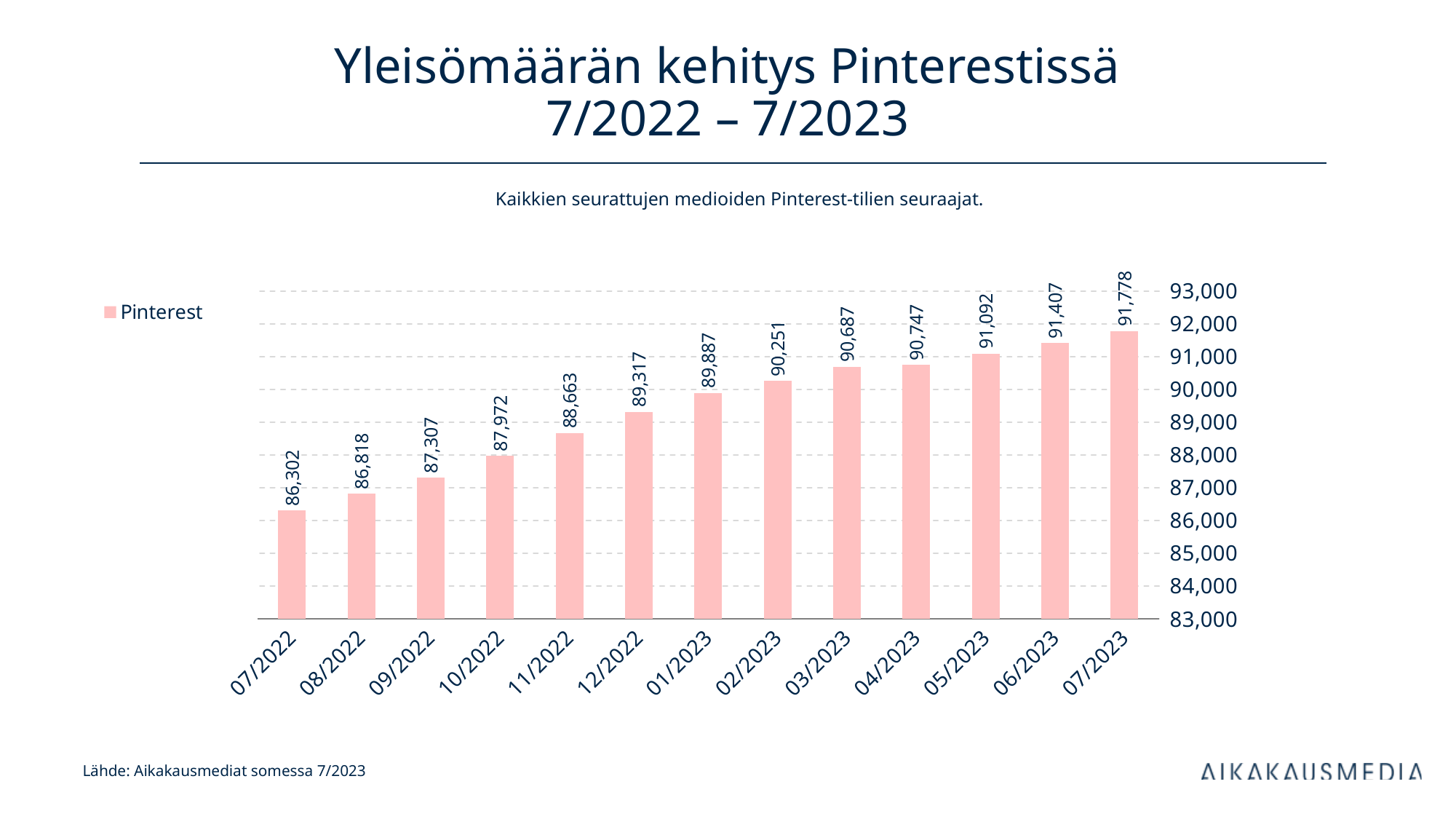
Do the values rise or fall from 07/2022 to 07/2023? rise How many series does the legend list? 1 What is the value for 07/2022? 86,302 Is the value for 10/2022 greater or less than 89,000? less What is the value for 01/2023? 89,887 How many months are shown on the x axis? 13 Which month has the highest value? 07/2023 What is the value for 07/2023? 91,778 Which is larger, the value for 11/2022 or the value for 12/2022? 12/2022 Which month has the lowest value? 07/2022 What is the difference between the values for 07/2023 and 07/2022? 5,476 What kind of chart is shown? bar chart